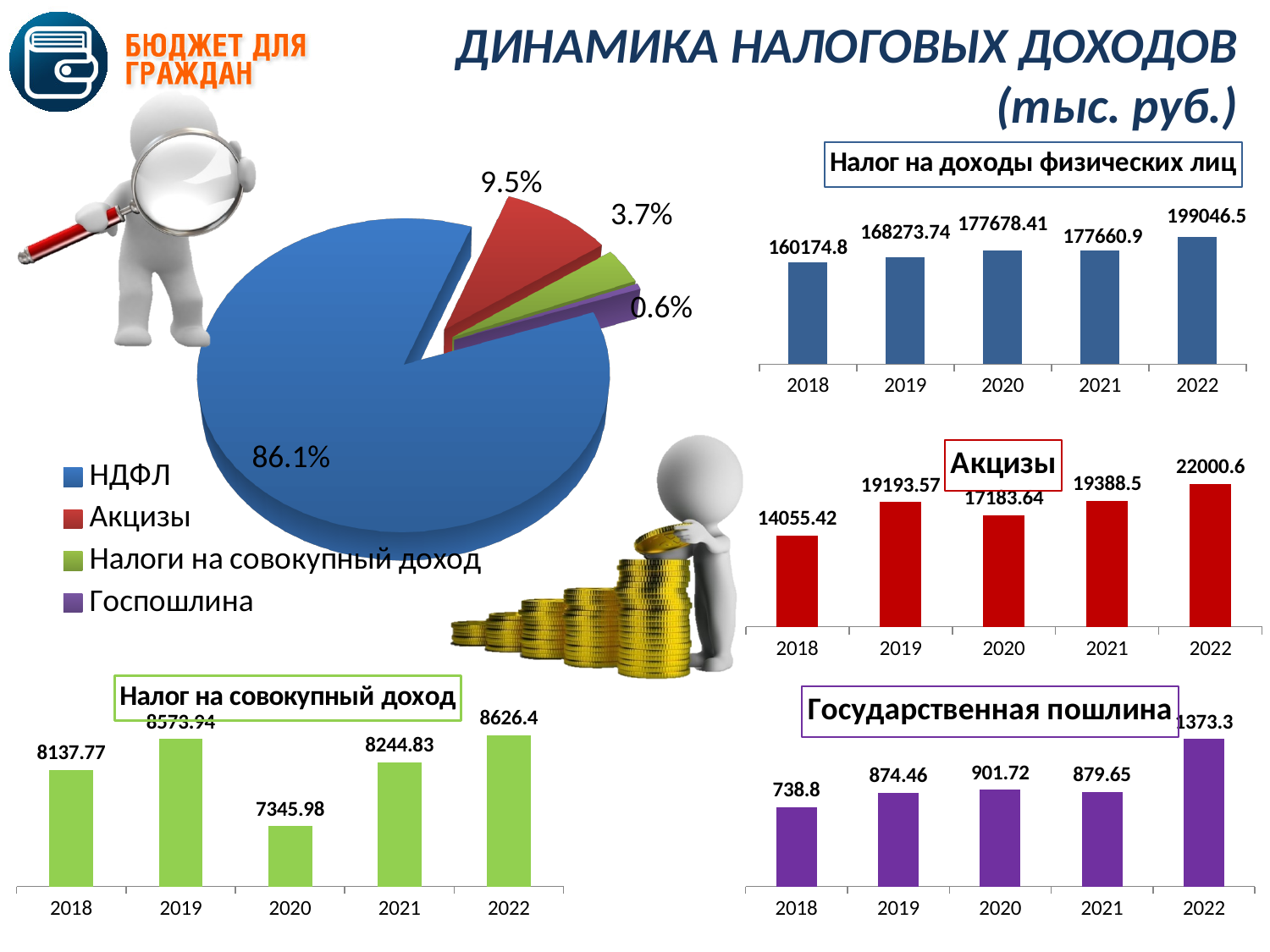
In the 'Налог на совокупный доход' chart, which year has the lowest value? 2020 In the pie chart, what share does НДФЛ have? 86.1% In the 'Налог на доходы физических лиц' chart, what is the value for 2022? 199046.5 In the 'Государственная пошлина' chart, is the value for 2020 larger than the value for 2018? Yes In the 'Налог на доходы физических лиц' chart, which year has the lowest value? 2018 In the 'Акцизы' chart, which year has the highest value? 2022 In the pie chart, what share does Акцизы have? 9.5% How many entries does the pie chart legend list? 4 In the 'Налог на совокупный доход' chart, what is the value for 2021? 8244.83 In the 'Акцизы' chart, what is the value for 2020? 17183.64 In the 'Акцизы' chart, what is the difference between the 2022 and 2018 values? 7945.18 How many years are shown on the x axis of the 'Государственная пошлина' chart? 5